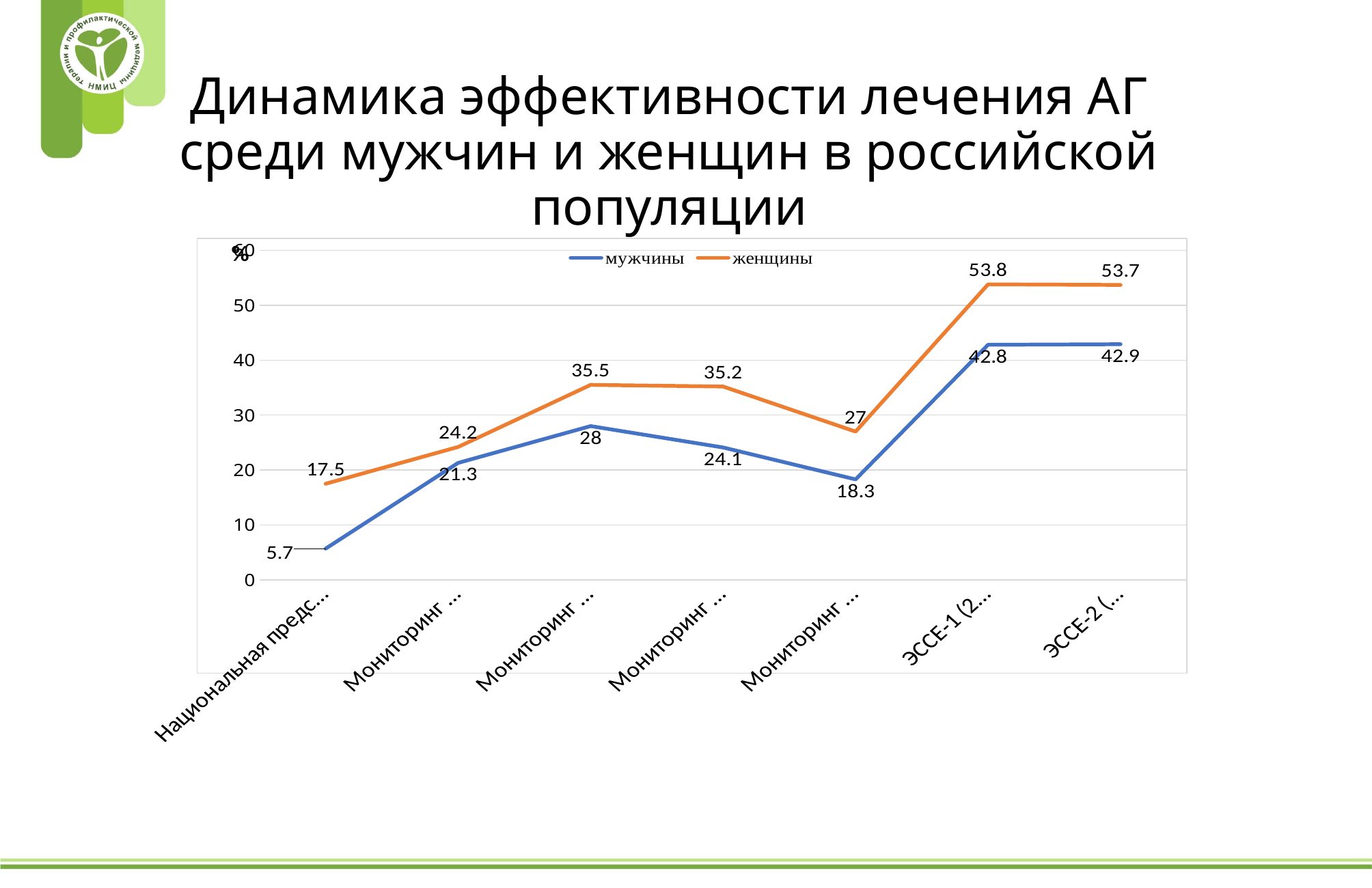
How many data points does each line have? 7 At ЭССЕ-2, which series has the higher value, мужчины or женщины? женщины How many series does the legend list? 2 Does the женщины line rise or fall from ЭССЕ-1 to ЭССЕ-2? fall What is the value for женщины at ЭССЕ-2? 53.7 What are the two legend entries of the chart? мужчины, женщины At which point is the value for женщины lowest? the first (leftmost) point, 17.5 Is the value for мужчины at ЭССЕ-1 greater or less than 40? greater What is the value for мужчины at the first (leftmost) point? 5.7 What is the value for мужчины at ЭССЕ-1? 42.8 What is the difference between женщины and мужчины at ЭССЕ-1? 11 What type of chart is shown on the slide? line chart